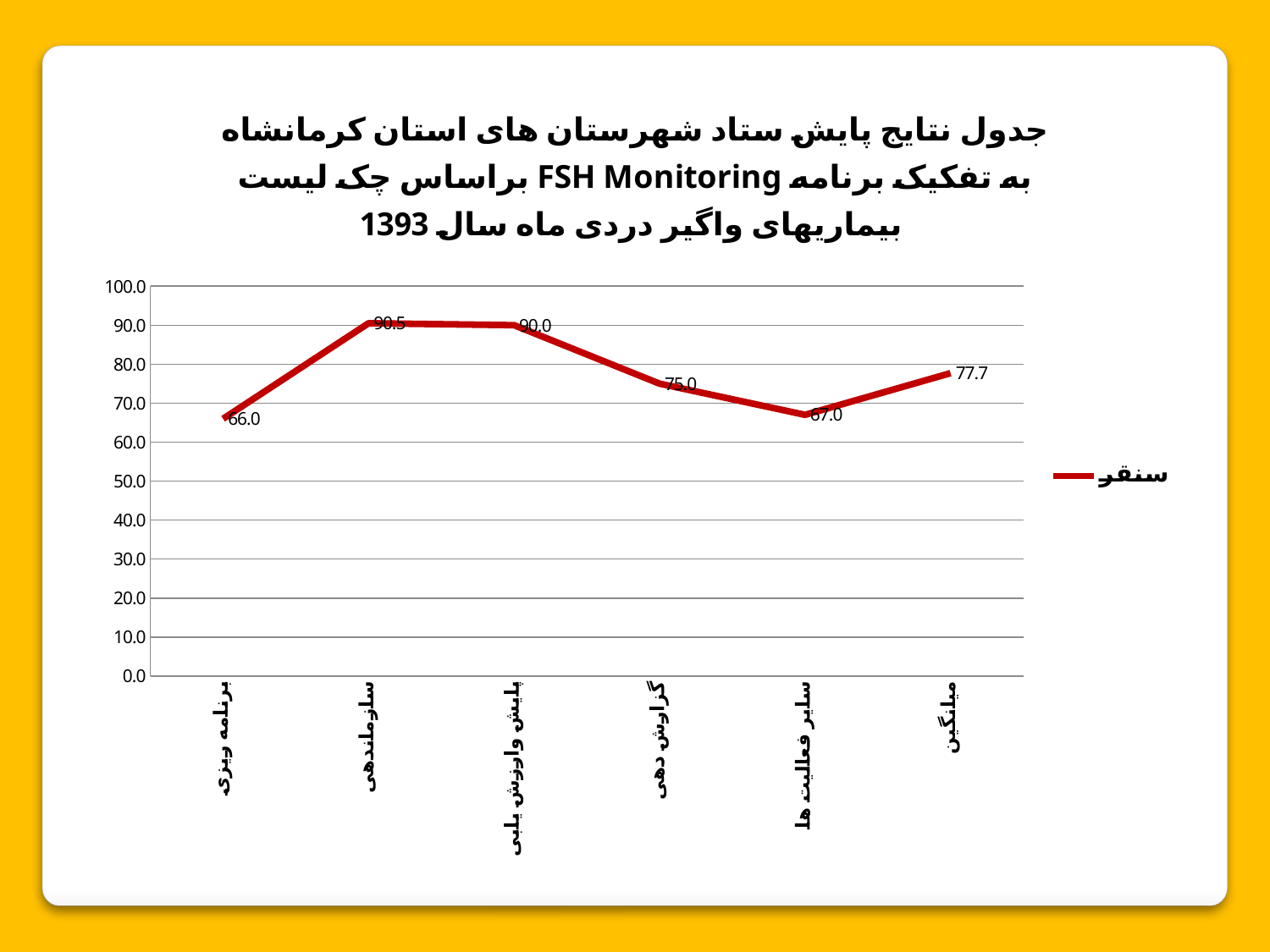
What is the value for میانگین? 77.7 What kind of chart is shown on the slide? line chart What is the name of the series shown in the legend? سنقر Which is larger, the value for گزارش دهی or the value for سایر فعالیت ها? گزارش دهی What is the value for سازماندهی? 90.5 Is the value for پایش و ارزش یابی greater or less than 80.0? greater How many categories are plotted on the x axis? 6 What is the value for برنامه ریزی? 66.0 What is the value for گزارش دهی? 75.0 How many series does the legend list? 1 Which category has the lowest value? برنامه ریزی What is the difference between the values for سازماندهی and برنامه ریزی? 24.5